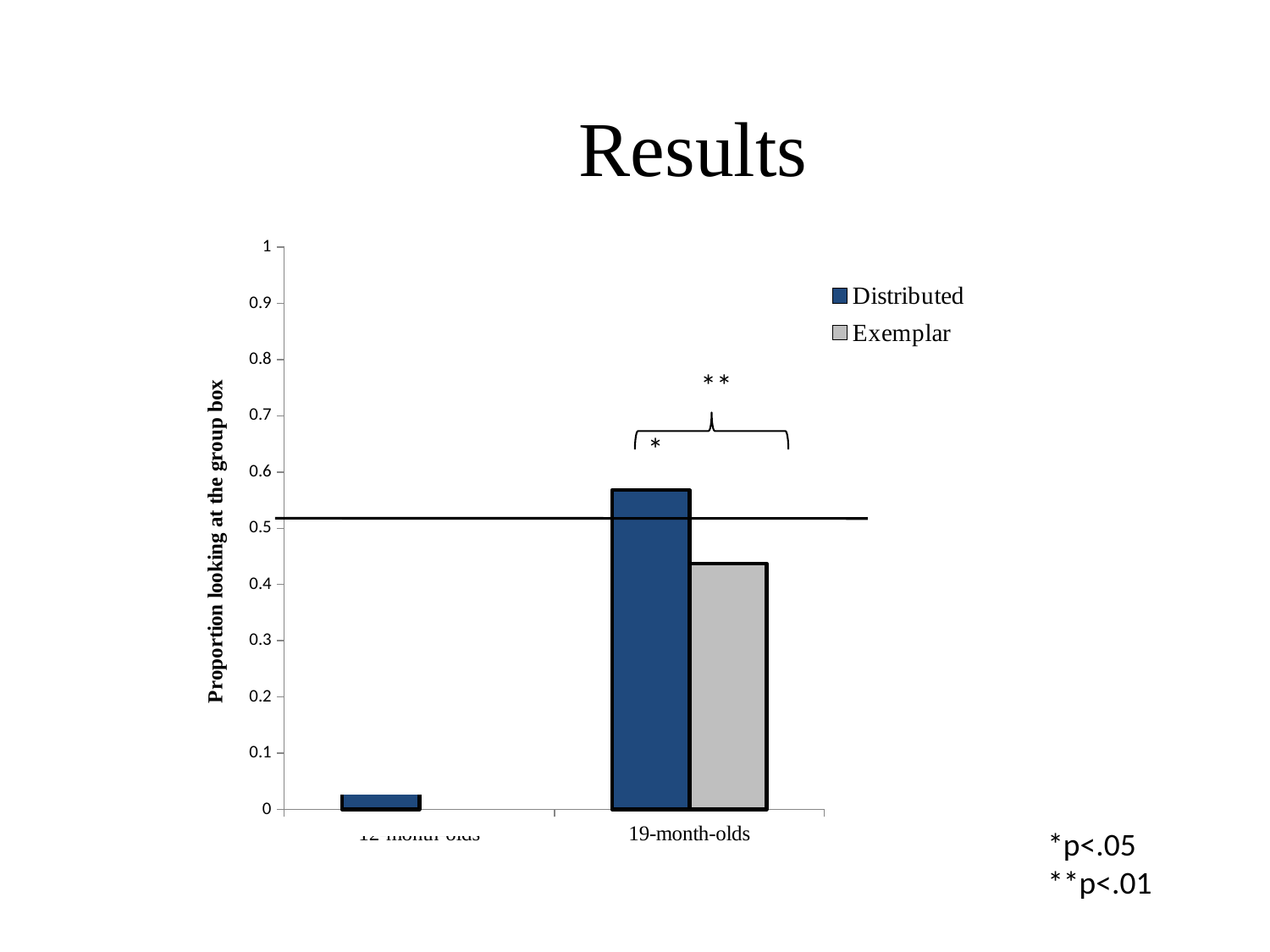
Is the Distributed value for 19-month-olds greater or less than 0.5? greater How many age-group categories are shown along the x axis? 2 Is the Distributed bar larger for the 19-month-olds or for the left-hand age group? 19-month-olds How many series does the legend list? 2 What are the two series named in the legend? Distributed and Exemplar Which bar is the tallest in the chart? Distributed for 19-month-olds Is the Exemplar value for 19-month-olds greater or less than 0.5? less Is the Distributed value for 19-month-olds greater or less than 0.6? less What is the title of the vertical axis? Proportion looking at the group box For 19-month-olds, which series has the larger value, Distributed or Exemplar? Distributed What kind of chart is shown on the slide? bar chart